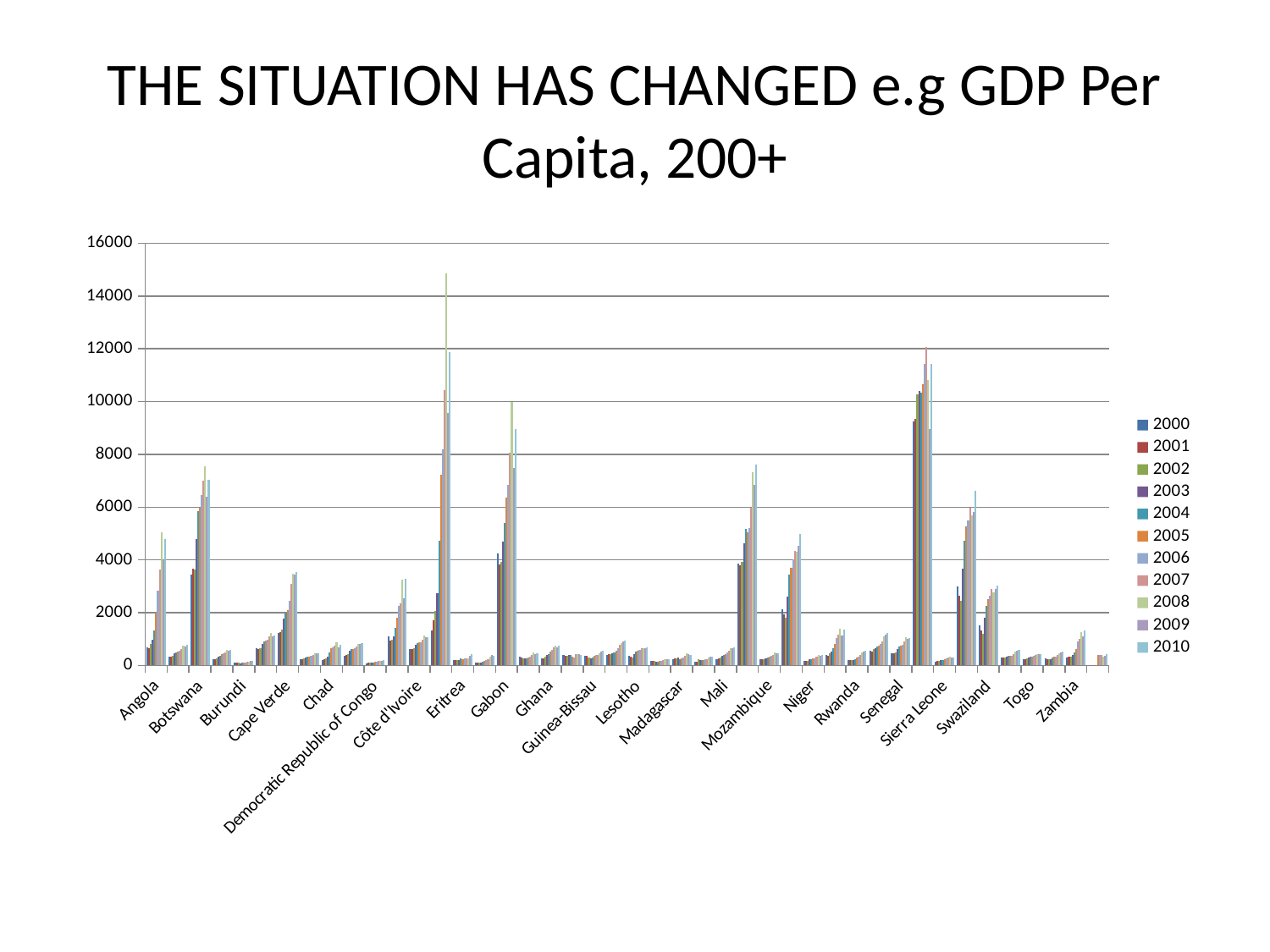
Is the tallest bar for Burundi greater or less than 2000? less What is the highest value shown on the vertical axis? 16000 Which year's series does the tallest bar in the chart belong to? 2008 Is the tallest bar in the chart greater or less than 14000? greater Which country has taller bars, Gabon or Ghana? Gabon What is the last year listed in the legend? 2010 Is the tallest bar for Angola greater or less than 6000? less Which country has taller bars, Botswana or Burundi? Botswana What is the first year listed in the legend? 2000 What kind of chart is shown on the slide? bar chart How many series does the legend list? 11